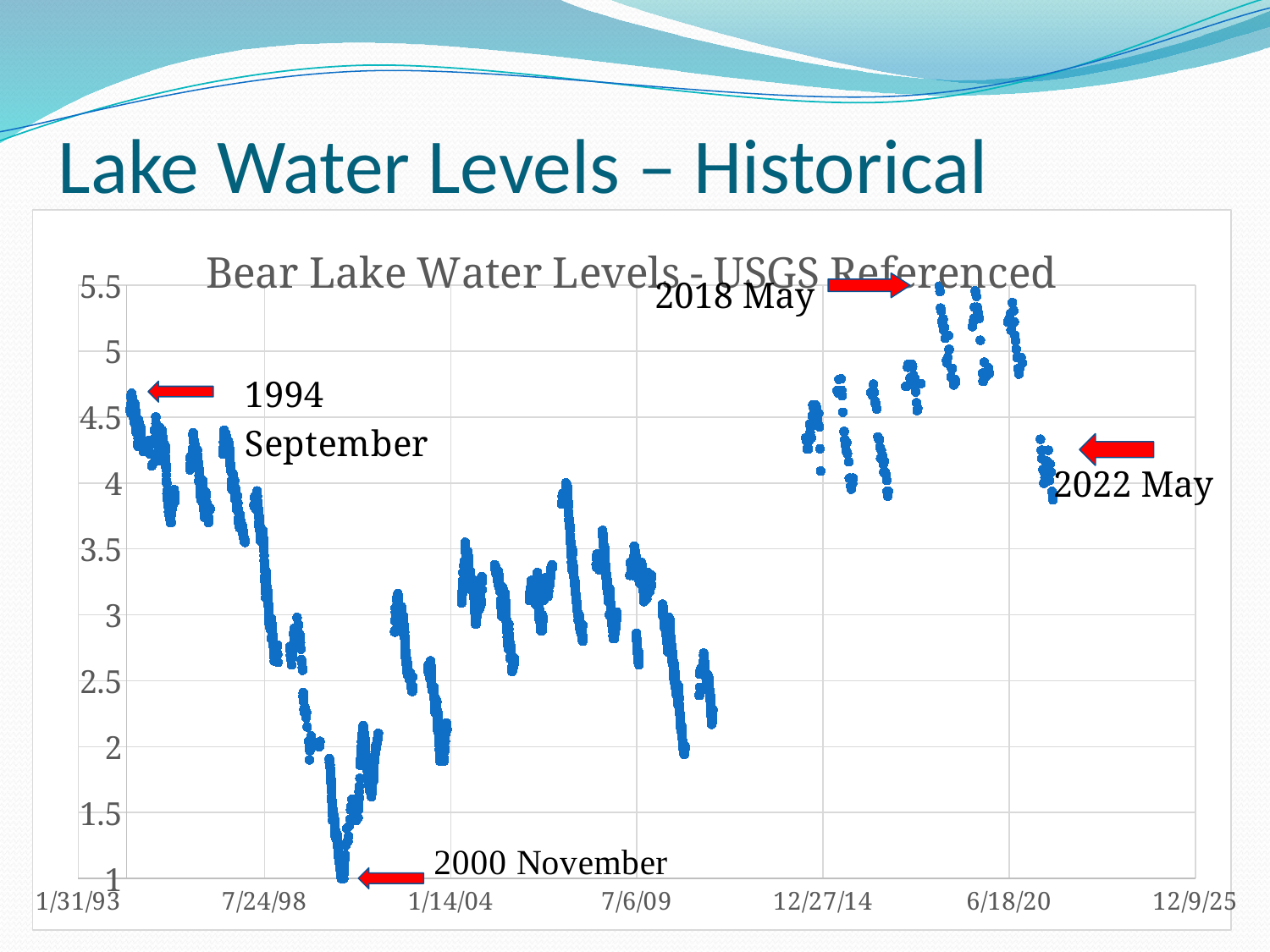
Is the water level at 1994 September greater or less than 4? greater How many dates are annotated with red arrows on the chart? 4 Is the water level at 2022 May greater or less than 5? less Is the water level at 2000 November greater or less than 1.5? less Which is higher, the water level at 2018 May or at 2000 November? 2018 May Which annotated date marks the highest water level on the chart? 2018 May Do the water levels rise or fall between 1994 September and 2000 November? fall Do the water levels rise or fall between 2000 November and 2018 May? rise What kind of chart is shown on the slide? scatter chart What is the title of the chart? Bear Lake Water Levels - USGS Referenced Which annotated date marks the lowest water level on the chart? 2000 November